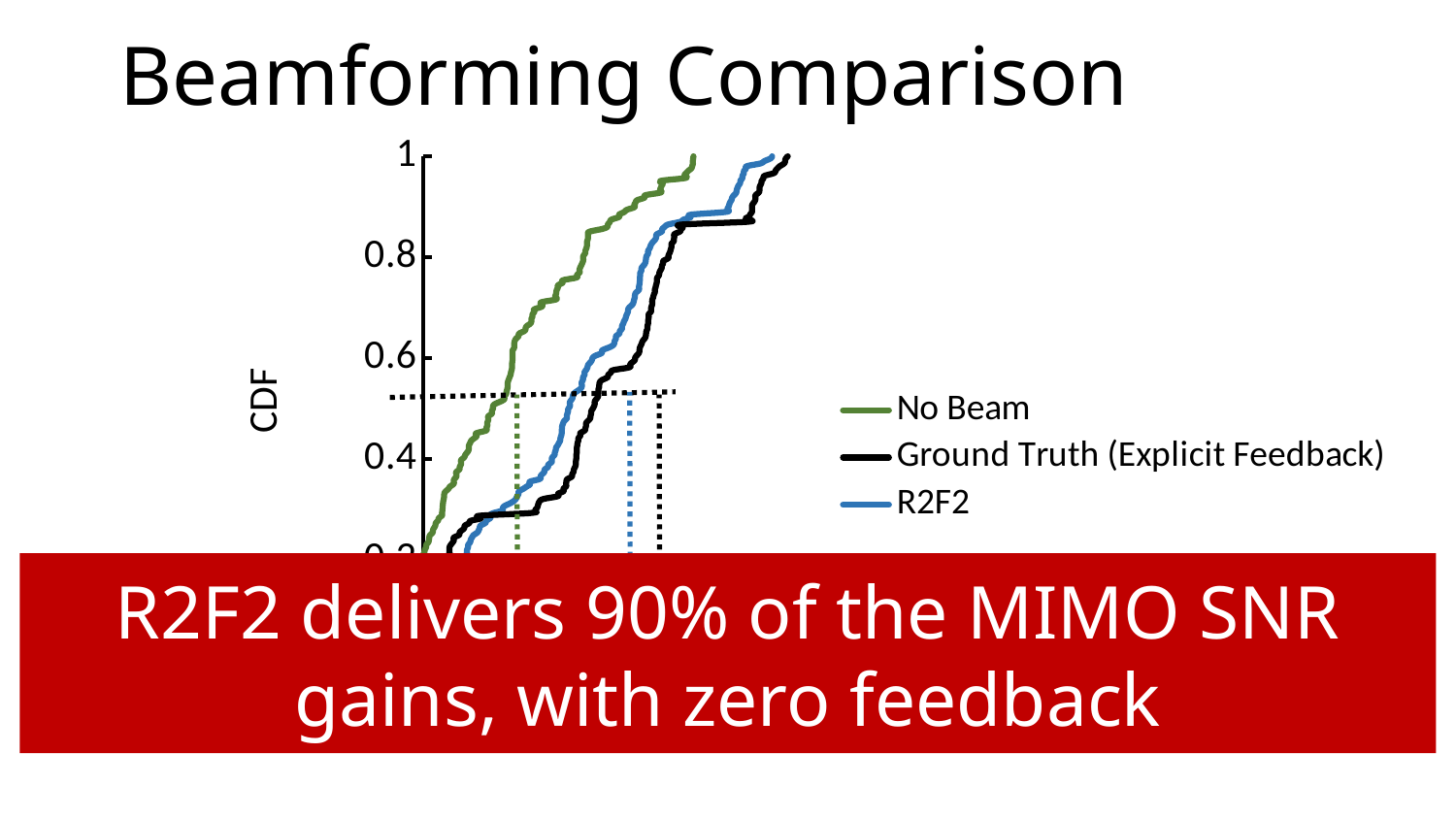
Which series is drawn in black in the chart? Ground Truth (Explicit Feedback) How many series does the legend list? 3 What is the highest tick value shown on the y axis? 1 What kind of chart is shown on the slide? line chart Which series is drawn in green in the chart? No Beam Which series' curve reaches a CDF of 1 furthest to the left? No Beam Which series' curve lies furthest to the right at the dotted horizontal line near a CDF of 0.5? Ground Truth (Explicit Feedback) Do the curves rise or fall as you move from left to right along the x axis? rise What is the label on the y axis of the chart? CDF